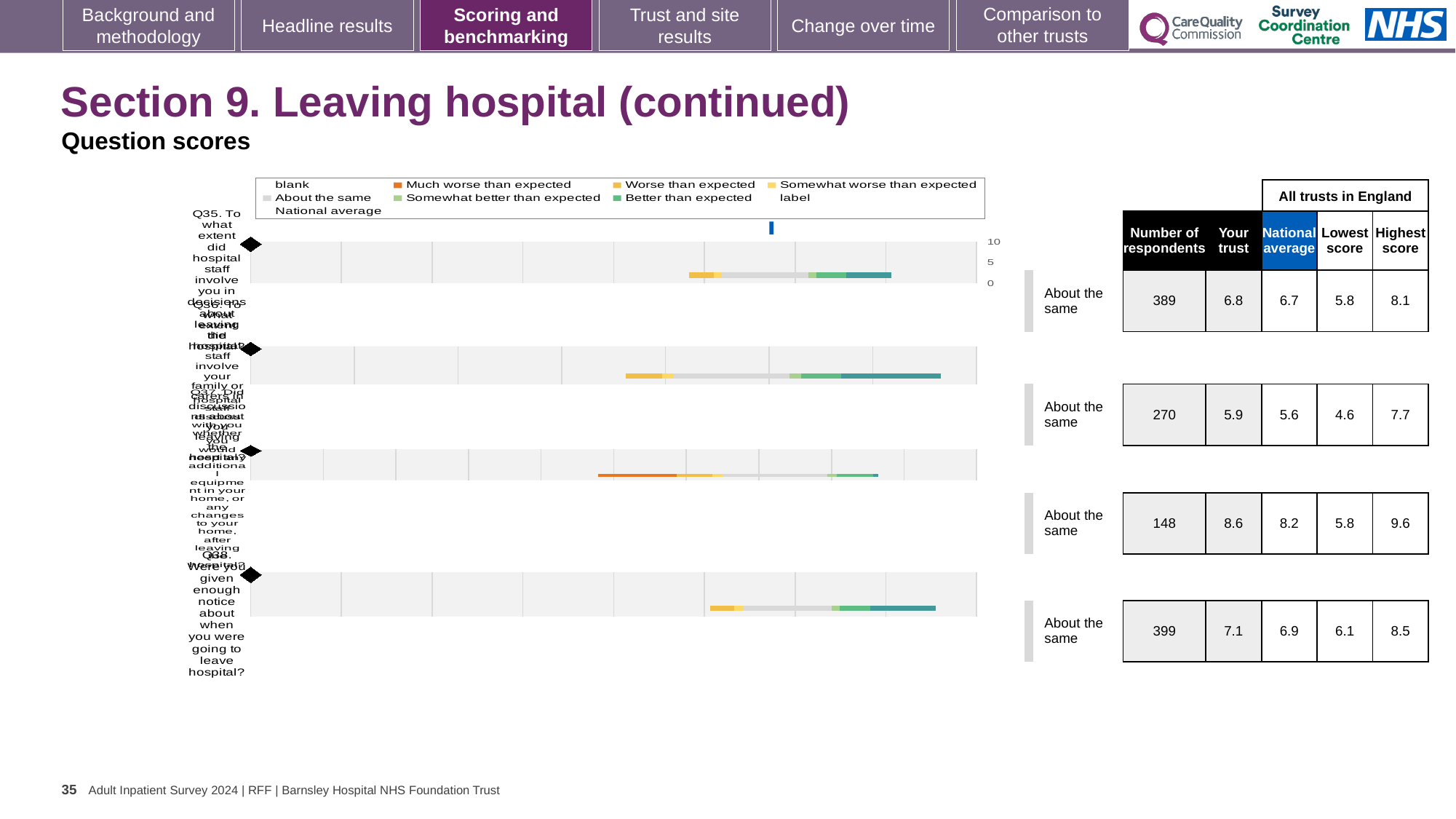
For Q35 (the top chart), what is the 'Your trust' score? 6.8 For Q38 (the bottom chart), how many respondents are listed? 399 For Q38 (the bottom chart), what is the highest score among all trusts in England? 8.5 For the third chart from the top, what is the national average score? 8.2 For Q38 (the bottom chart), which is larger: the 'Your trust' score or the national average? Your trust (7.1) How many question rows (charts) are shown on the slide? 4 What benchmark category is shown next to each of the four charts? About the same For Q38 (the bottom chart), what is the difference between the highest and lowest scores among all trusts in England? 2.4 Which chart row has the lowest 'Your trust' score? the second chart from the top (5.9) For Q35 (the top chart), what is the difference between the 'Your trust' score and the national average? 0.1 What kind of chart is used to show the question scores on this slide? bar chart Which chart row has the highest 'Your trust' score? the third chart from the top (8.6)